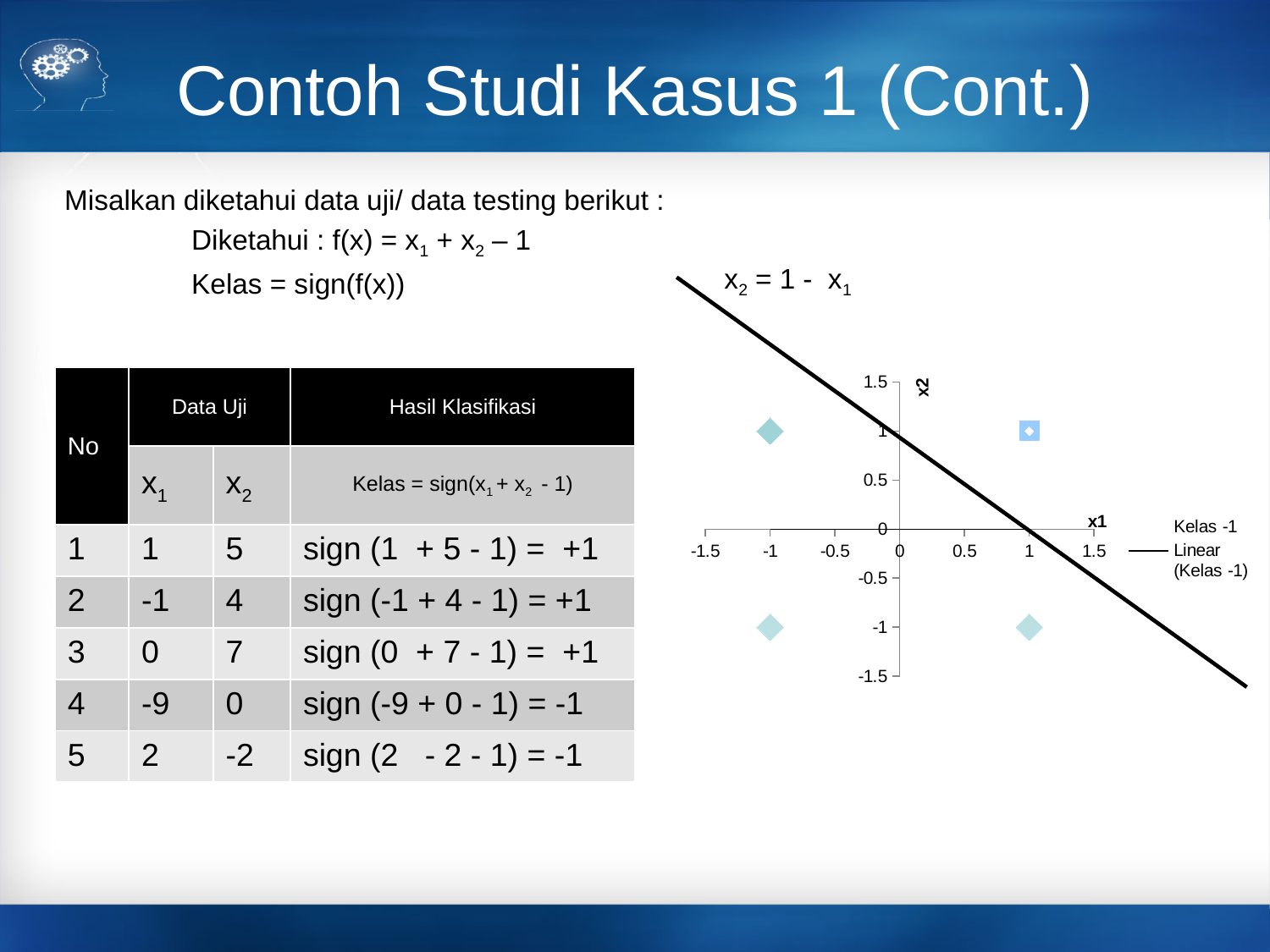
What is the highest value shown on the x1 axis of the scatter chart? 1.5 Does the straight line in the scatter chart rise or fall as x1 increases? fall How many entries does the legend of the scatter chart list? 2 In the scatter chart, is the x2 value of the point at x1 = 1 in the upper-right quadrant greater or less than 0.5? greater How many data points are plotted in the scatter chart? 4 In the scatter chart, how many points have an x2 value of -1? 2 What is the lowest value shown on the x2 axis of the scatter chart? -1.5 What is the label of the horizontal axis of the scatter chart? x1 What is the label of the vertical axis of the scatter chart? x2 In the scatter chart, what is the x2 value of the point plotted at x1 = -1 in the upper-left quadrant? 1 In the scatter chart, what is the x1 value of the point plotted at x2 = -1 in the lower-right quadrant? 1 What kind of chart is shown on the right side of the slide? scatter chart